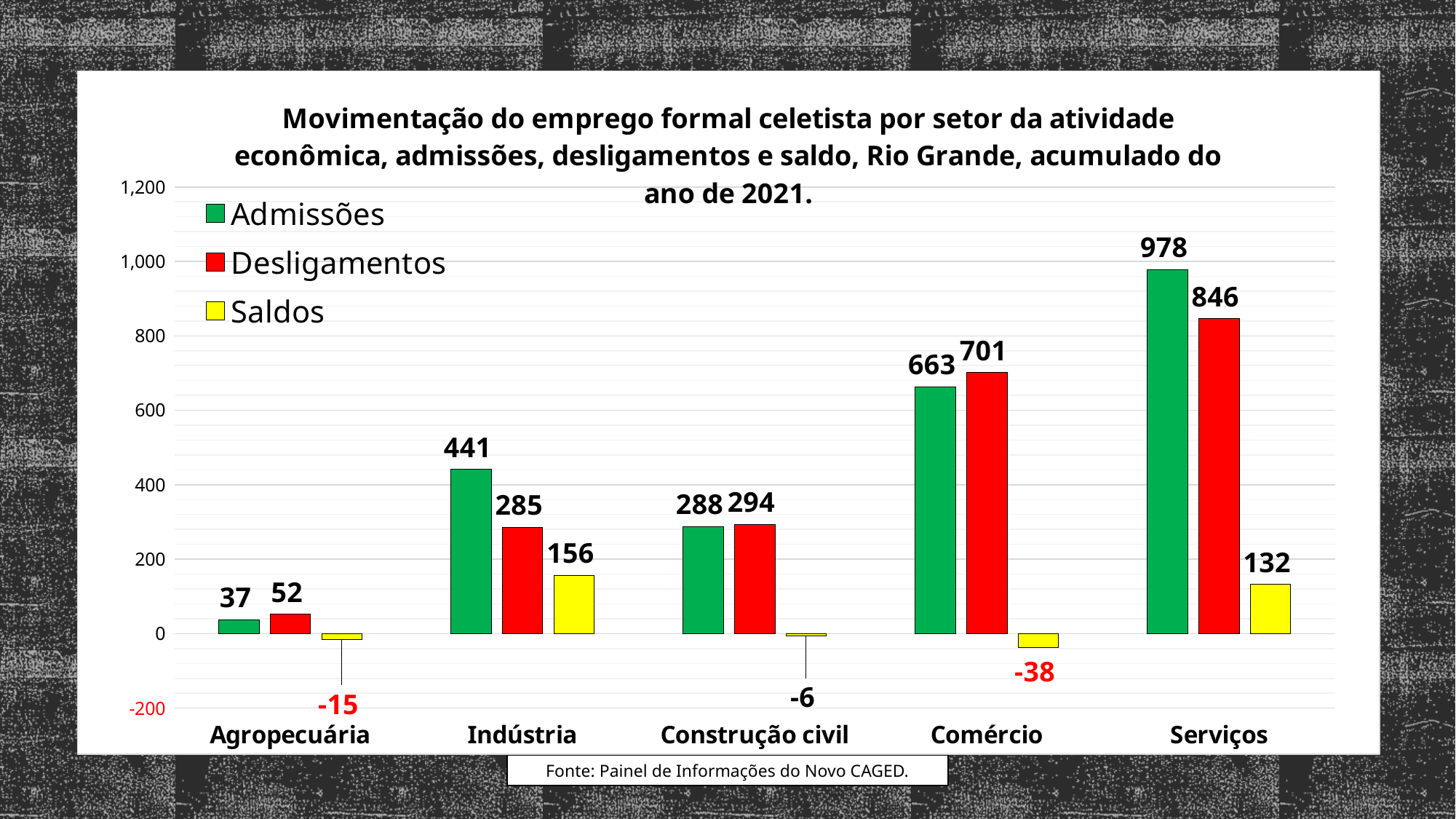
What is the Saldos value for Comércio? -38 Is the Desligamentos value for Serviços greater or less than 800? greater How many sectors are shown on the x axis? 5 What kind of chart is shown on the slide? bar chart What is the difference between Admissões and Desligamentos for Comércio? 38 Which sector has the highest Admissões value? Serviços What is the value of Admissões for Serviços? 978 Which sector has the lowest Saldos value? Comércio What colour represents the Saldos series? yellow What is the value of Desligamentos for Indústria? 285 Which is larger for Construção civil, Admissões or Desligamentos? Desligamentos How many series does the legend list? 3